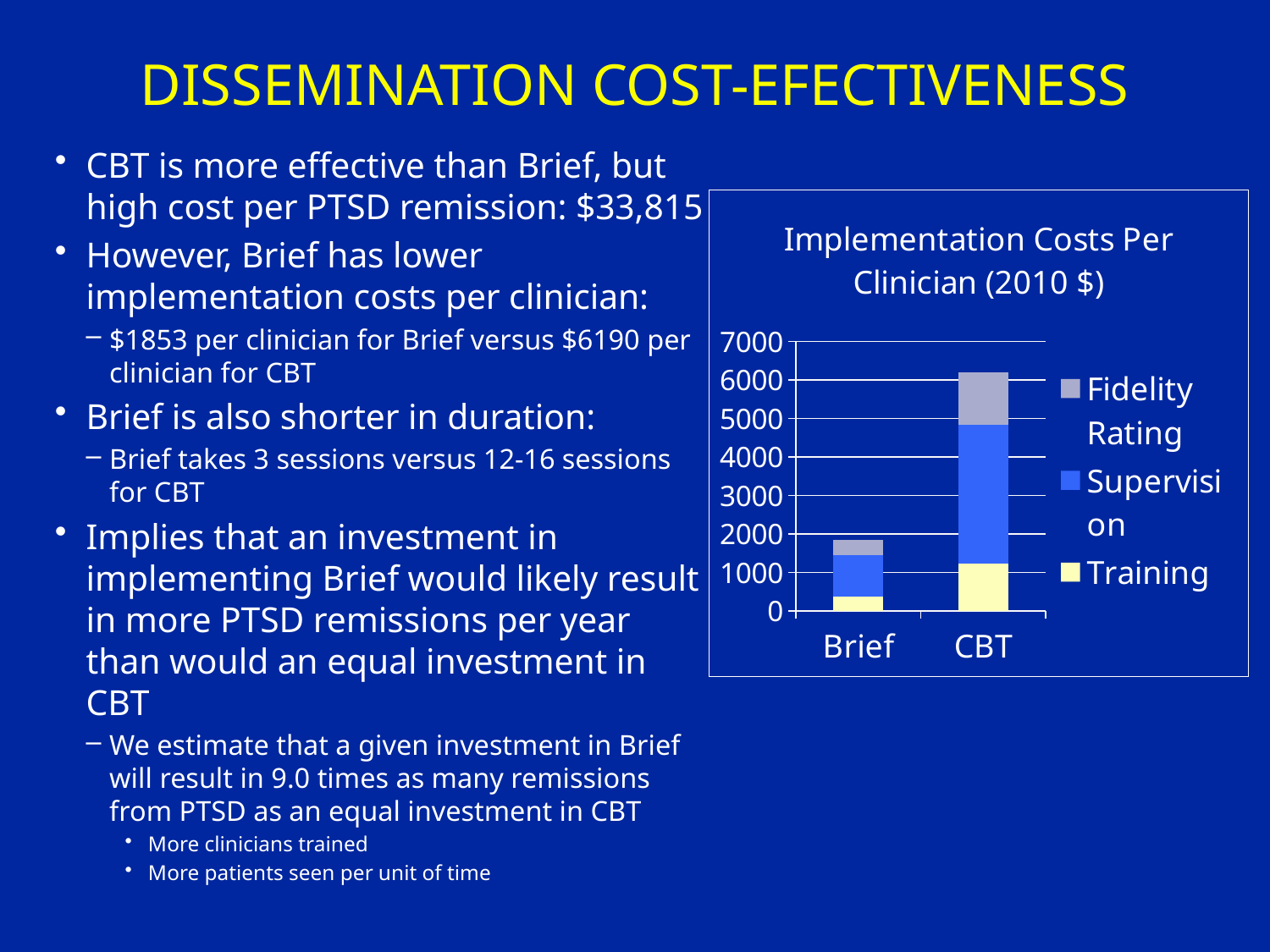
What is the title of the chart? Implementation Costs Per Clinician (2010 $) Is the Training segment of the Brief bar greater or less than 1000? less Is the total value of the Brief bar greater or less than 2000? less What kind of chart is shown on the slide? Stacked bar chart Which series is shown at the bottom of each stacked bar? Training How many categories are shown on the x axis of the chart? 2 How many series does the chart's legend list? 3 Which category has the lowest total implementation cost per clinician? Brief Is the total value of the Brief bar greater or less than 1000? greater Which has the larger total bar, Brief or CBT? CBT Which category has the highest total implementation cost per clinician? CBT